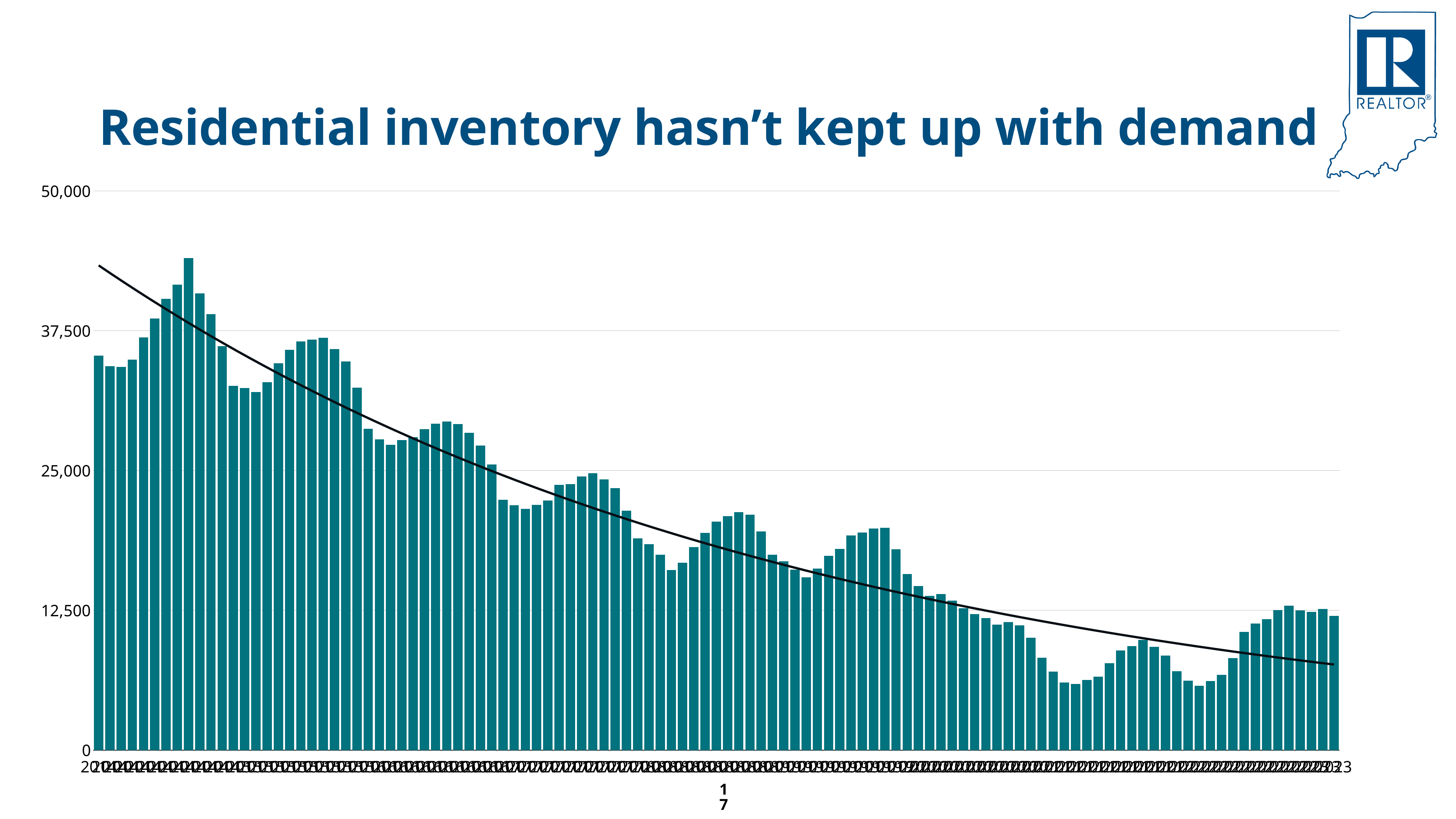
What is the highest value shown on the y axis? 50,000 What kind of chart is shown on the slide? Bar chart Is the value of the tallest bar greater or less than 50,000? less Is the value of the first (leftmost) bar greater or less than 37,500? less Is the tallest bar located in the left half or the right half of the chart? Left half What is the title of the chart on the slide? Residential inventory hasn't kept up with demand Do the bar values generally rise or fall from left to right along the x axis? Fall Is the value of the shortest bar greater or less than 12,500? less Is the shortest bar located in the left half or the right half of the chart? Right half